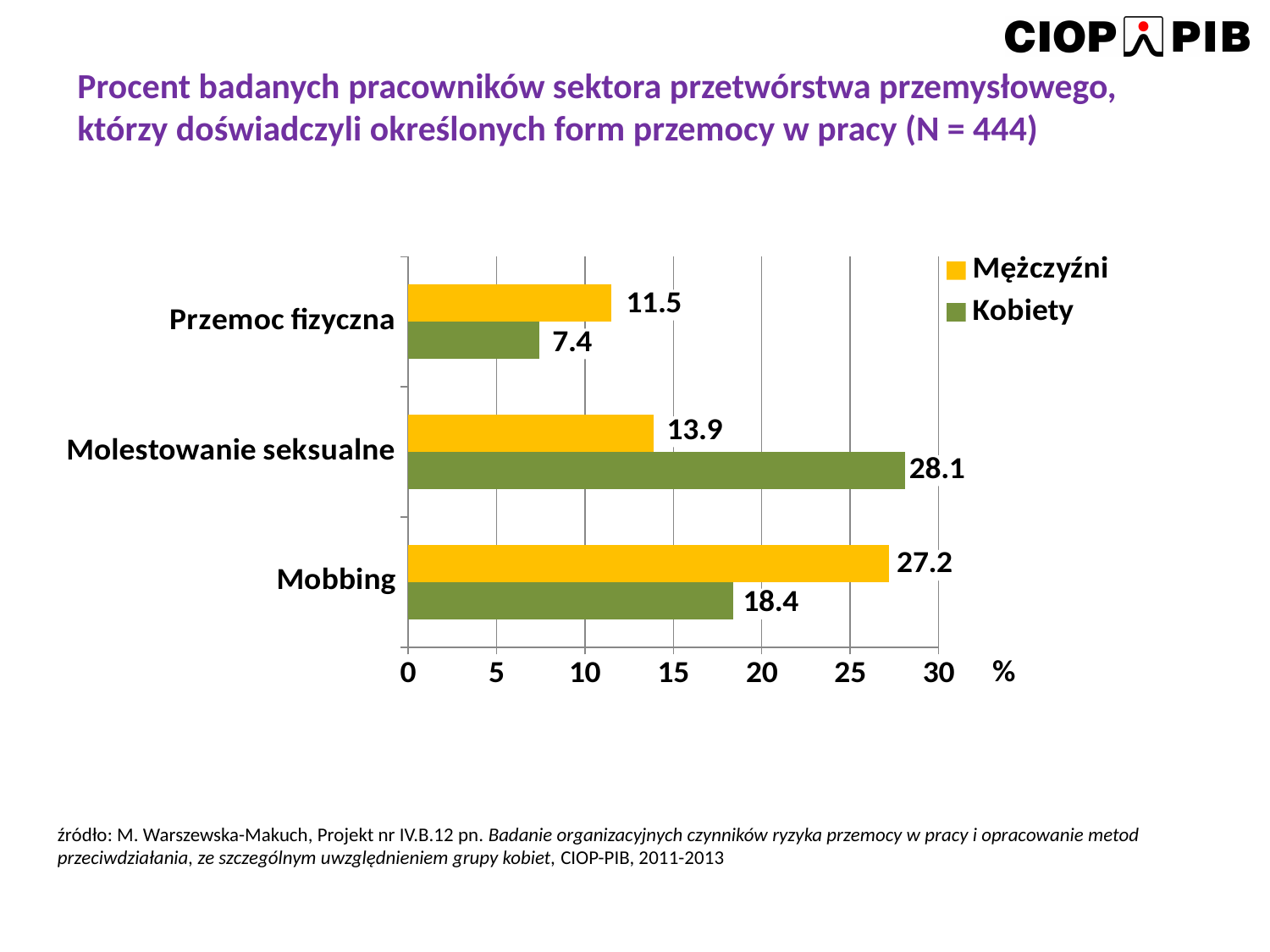
What kind of chart is shown on the slide? bar chart What is the value for Mężczyźni in the Mobbing category? 27.2 What is the value for Kobiety in the Molestowanie seksualne category? 28.1 Which colour represents the Kobiety series? green Is the value for Kobiety in the Mobbing category greater or less than 20? less How many series does the legend list? 2 Which is larger for Mobbing: the value for Mężczyźni or for Kobiety? Mężczyźni What is the difference between the Kobiety and Mężczyźni values for Molestowanie seksualne? 14.2 How many categories are shown on the chart? 3 What is the value for Kobiety in the Przemoc fizyczna category? 7.4 Which category has the lowest value for Kobiety? Przemoc fizyczna Which category has the highest value for Mężczyźni? Mobbing